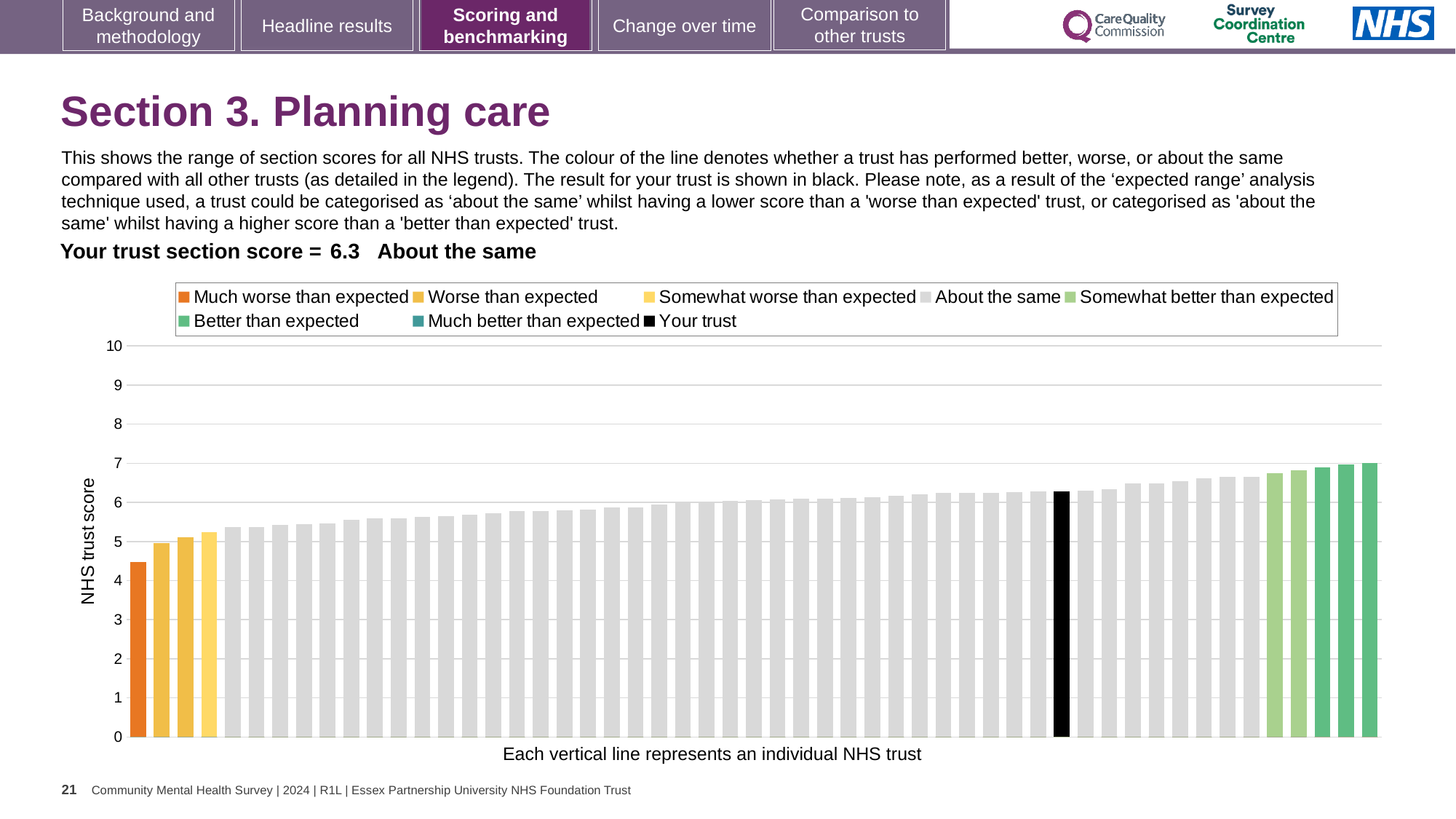
Do the trust scores rise or fall from left to right along the x axis? rise How is your trust's section score categorised compared with other trusts? About the same Is the value for the lowest-scoring trust (the orange bar) greater or less than 5? less What kind of chart is shown on the slide? bar chart Is the value for the highest-scoring trust (the rightmost bar) greater or less than 6? greater How many bars are coloured as 'Much worse than expected' (orange)? 1 What is the section score for your trust shown on the slide? 6.3 Which legend category does the lowest bar on the chart belong to? Much worse than expected What colour is the bar representing your trust? black How many entries does the chart legend list? 8 Is the value for the leftmost (orange) bar greater or less than 4? greater